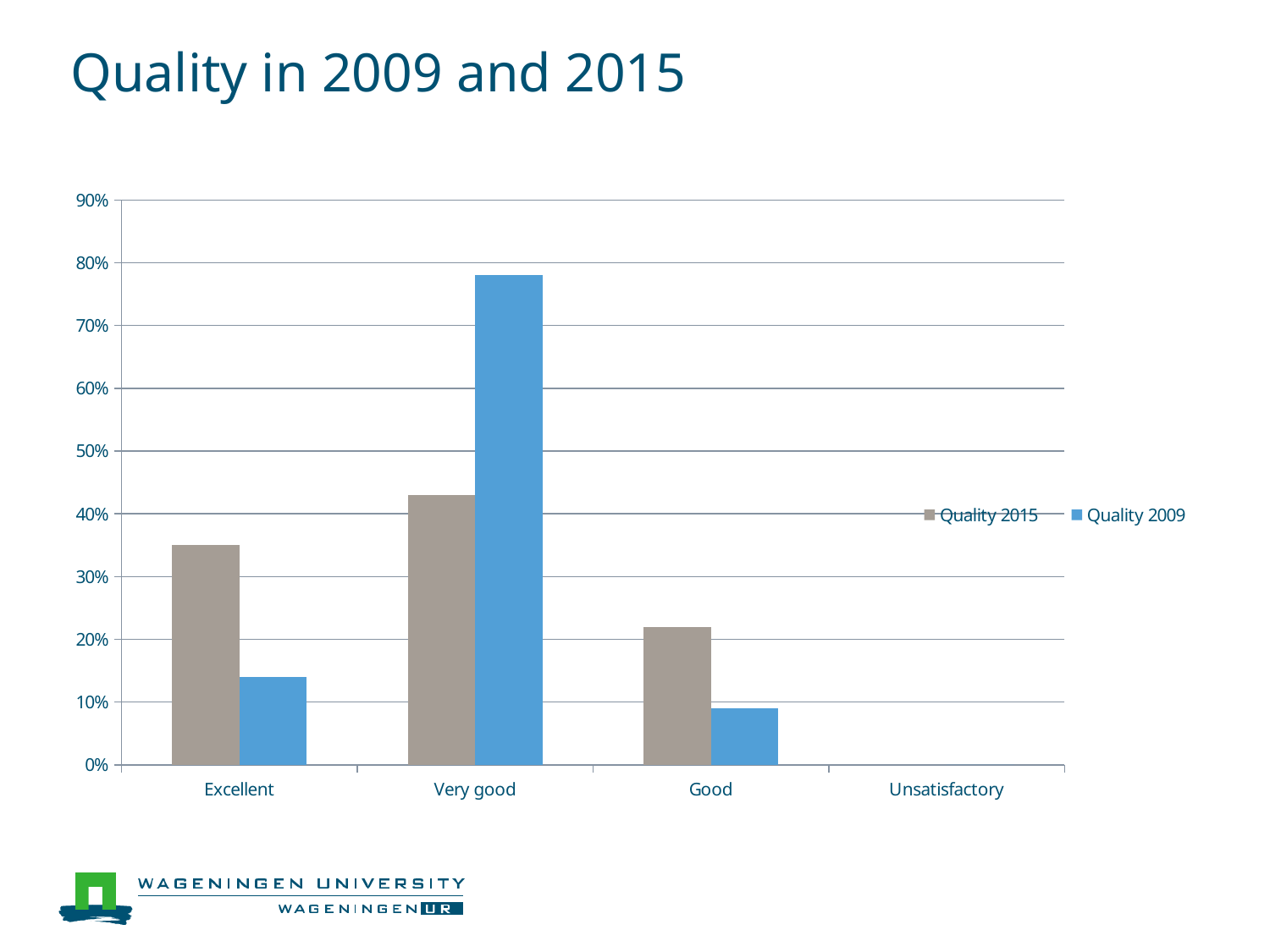
Is the Quality 2009 value for Very good greater or less than 70%? greater How many series does the legend list? 2 For the Excellent category, which series has the larger value, Quality 2015 or Quality 2009? Quality 2015 What is the title of the slide? Quality in 2009 and 2015 Which category has the highest value for Quality 2009? Very good Is the Quality 2015 value for Excellent greater or less than 30%? greater How many categories are shown on the x axis? 4 For the Very good category, which series has the larger value, Quality 2015 or Quality 2009? Quality 2009 Which category has the highest value for Quality 2015? Very good What kind of chart is shown on the slide? bar chart Is the Quality 2015 value for Very good greater or less than 50%? less